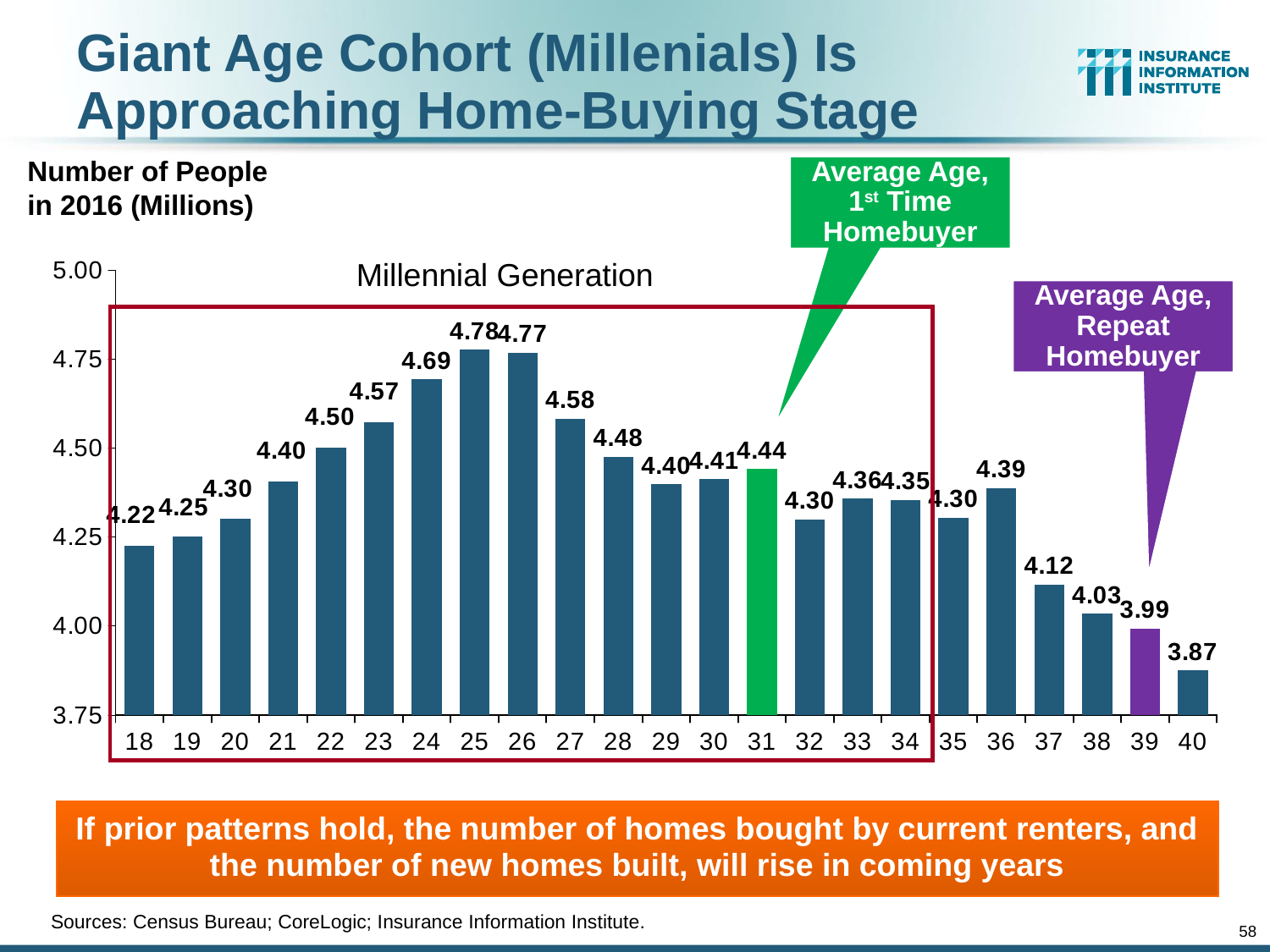
What is the number of people (millions) for age 39? 3.99 Do the values rise or fall from age 36 to age 40? fall Which age is highlighted as the average age of a first-time homebuyer? 31 Which is larger, the value for age 36 or the value for age 37? age 36 What kind of chart is shown on the slide? bar chart Which age has the highest number of people? 25 What is the value shown for age 25? 4.78 Which age has the lowest number of people? 40 Is the value for age 22 greater or less than 4.25? greater How many age categories are shown on the x axis? 23 What is the difference between the values for age 24 and age 18? 0.47 What is the number of people (millions) for age 31? 4.44